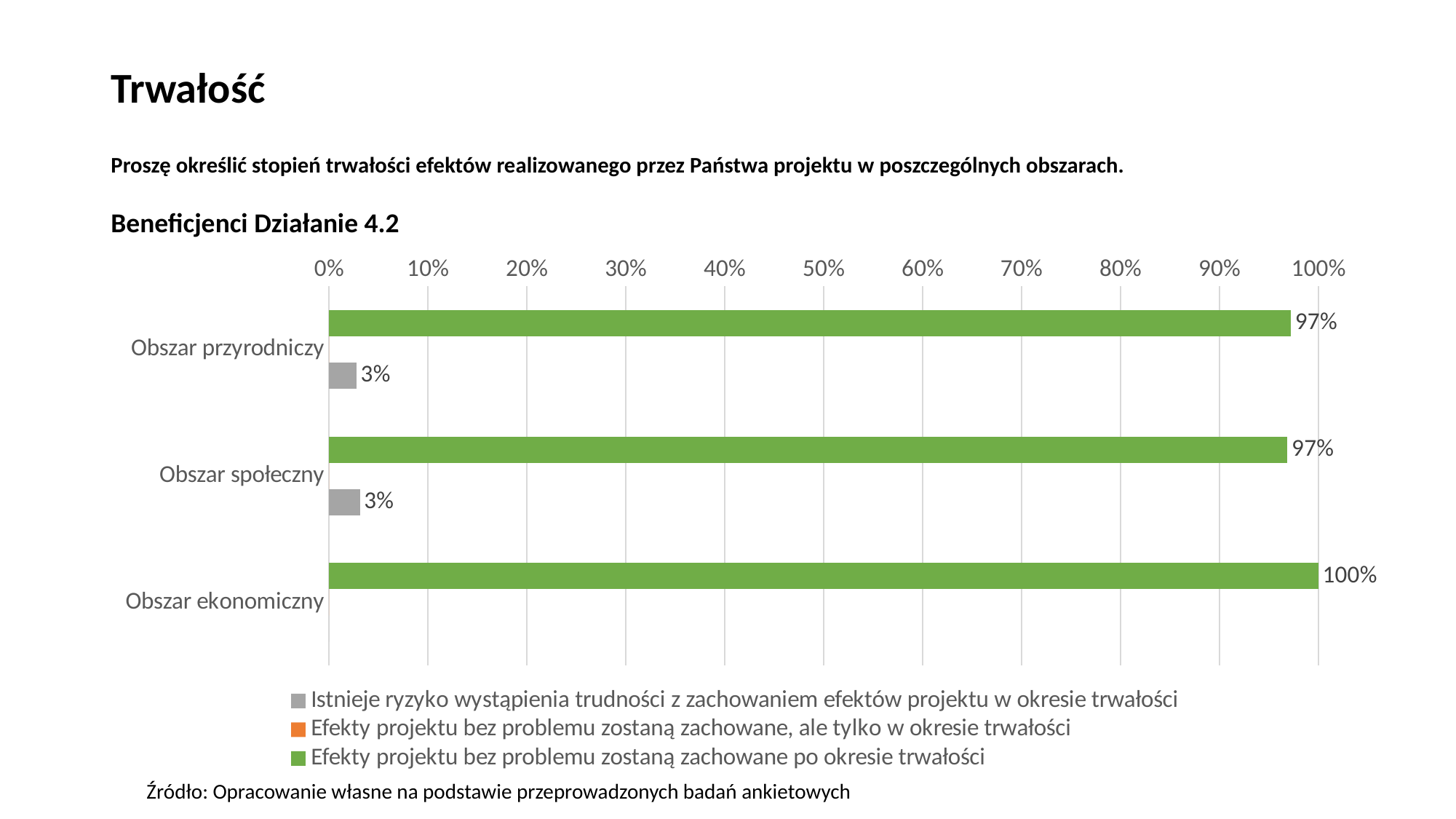
What is the value of the green series (Efekty projektu bez problemu zostaną zachowane po okresie trwałości) for Obszar ekonomiczny? 100% What is the difference between the green value for Obszar ekonomiczny and the green value for Obszar społeczny? 3% Is the green value for Obszar społeczny greater or less than 90%? greater How many categories are shown on the chart? 3 What is the value of the green series for Obszar przyrodniczy? 97% Which category has the highest value for the green series? Obszar ekonomiczny What is the difference between the green and grey values for Obszar przyrodniczy? 94% What is the title of the chart? Beneficjenci Działanie 4.2 What kind of chart is shown on the slide? bar chart What is the value of the grey series (Istnieje ryzyko wystąpienia trudności z zachowaniem efektów projektu w okresie trwałości) for Obszar społeczny? 3% How many series does the legend list? 3 Which is larger for Obszar społeczny: the green series or the grey series? the green series